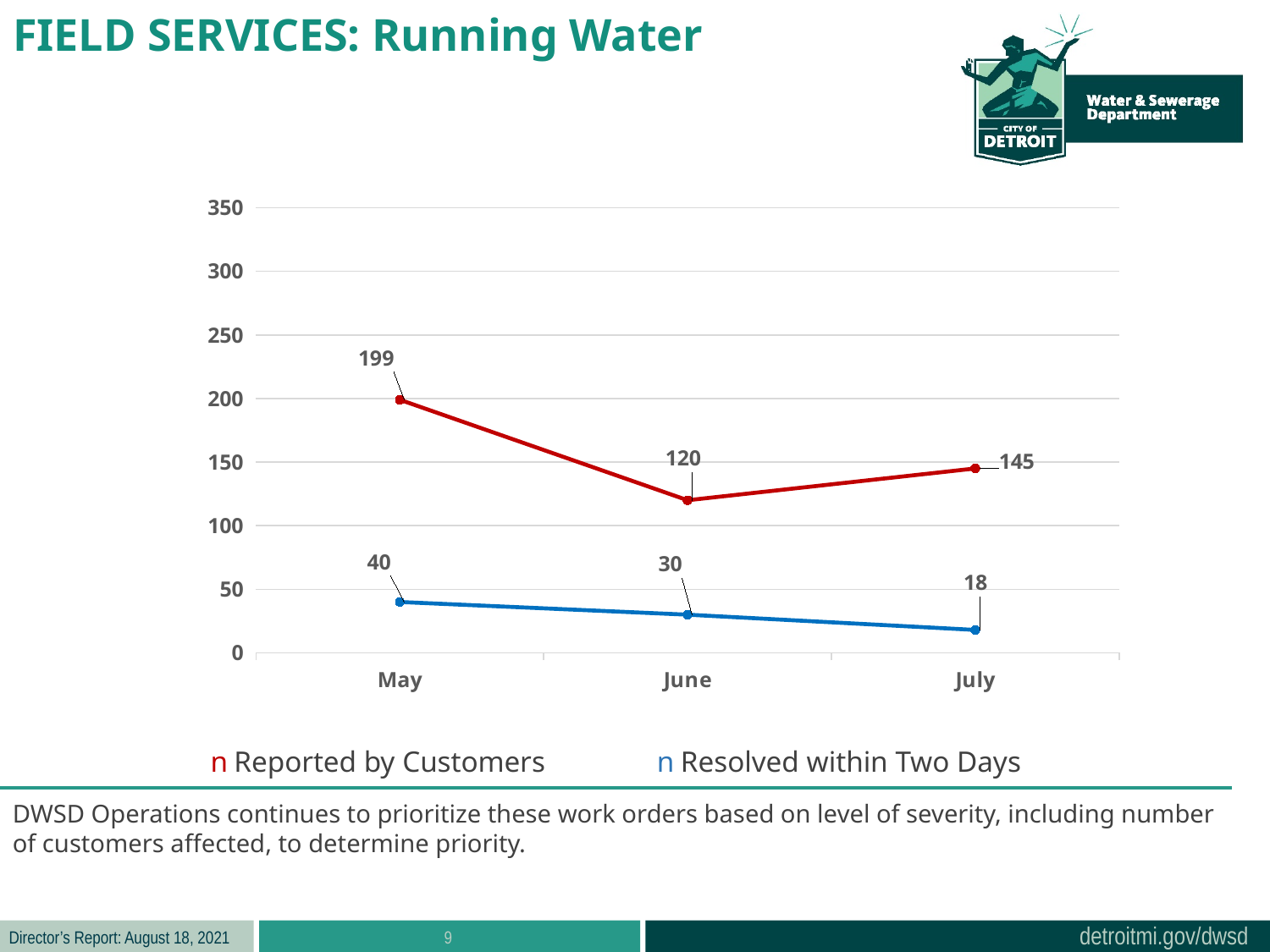
How many months are shown on the x axis? 3 What is the value for Resolved within Two Days in July? 18 What is the value for Reported by Customers in May? 199 What is the value for Reported by Customers in June? 120 In which month is Resolved within Two Days lowest? July How many series does the legend list? 2 Is the value for Reported by Customers in May greater or less than 150? greater Which is larger: Reported by Customers in June or Reported by Customers in July? Reported by Customers in July What kind of chart is shown on the slide? line chart Does Resolved within Two Days rise or fall from May to July? fall In which month is Reported by Customers highest? May What is the difference between Reported by Customers and Resolved within Two Days in July? 127